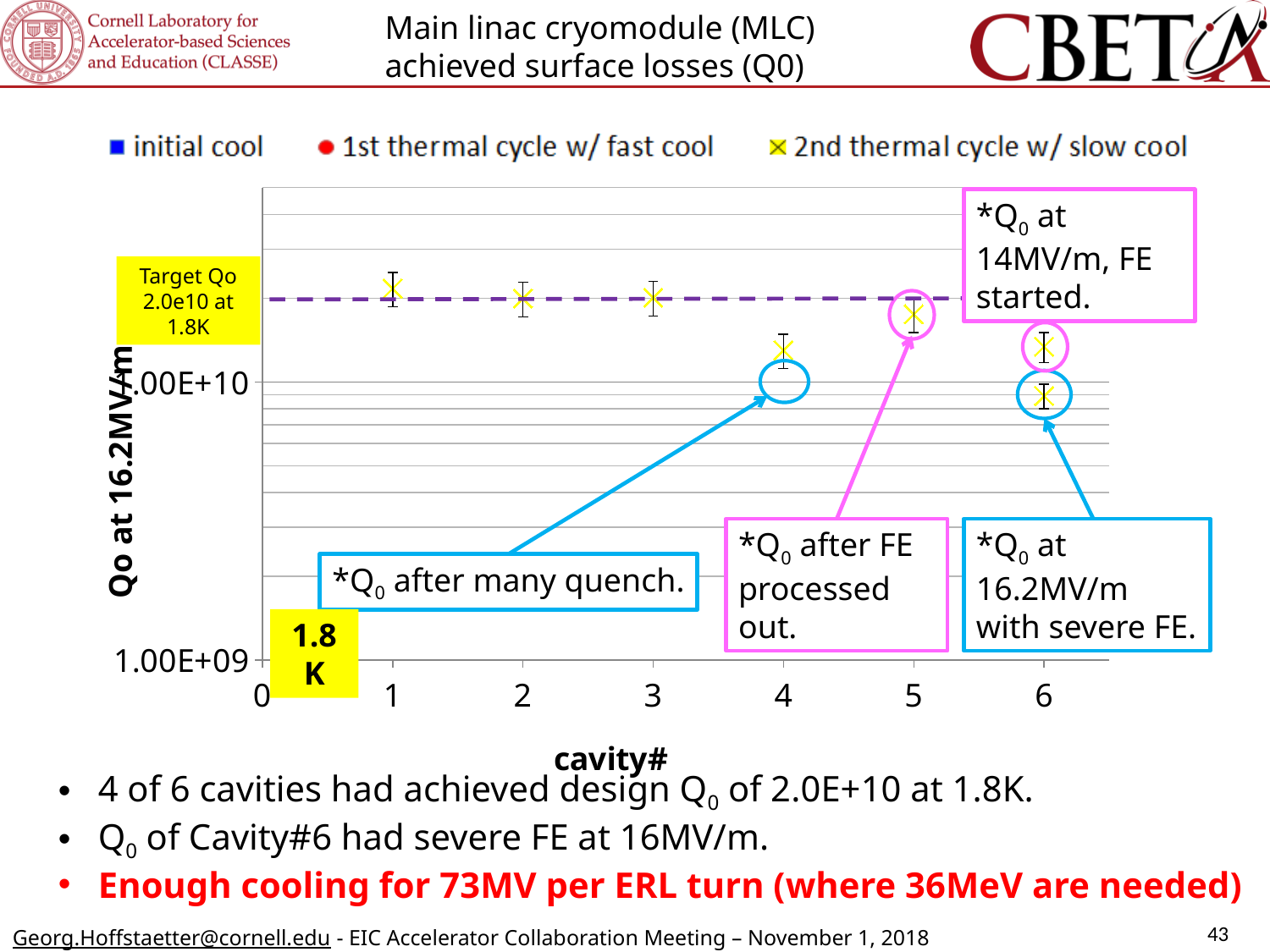
Is the Qo value for cavity 1 greater or less than 1.00E+10? greater Which has the higher Qo, cavity 1 or cavity 4? cavity 1 How many cavity numbers have data points plotted? 6 What target Qo value is marked by the dashed line? 2.0e10 at 1.8K How many series does the legend list? 3 Is the Qo value for cavity 4 greater or less than 1.00E+10? greater What kind of chart is shown on the slide? scatter chart What are the three series named in the legend? initial cool, 1st thermal cycle w/ fast cool, 2nd thermal cycle w/ slow cool Is the Qo value for cavity 3 greater or less than 1.00E+10? greater What is the lowest value labelled on the y axis? 1.00E+09 Which cavity number has the lowest plotted Qo point? 6 Which has the higher Qo, cavity 4 or cavity 5? cavity 5